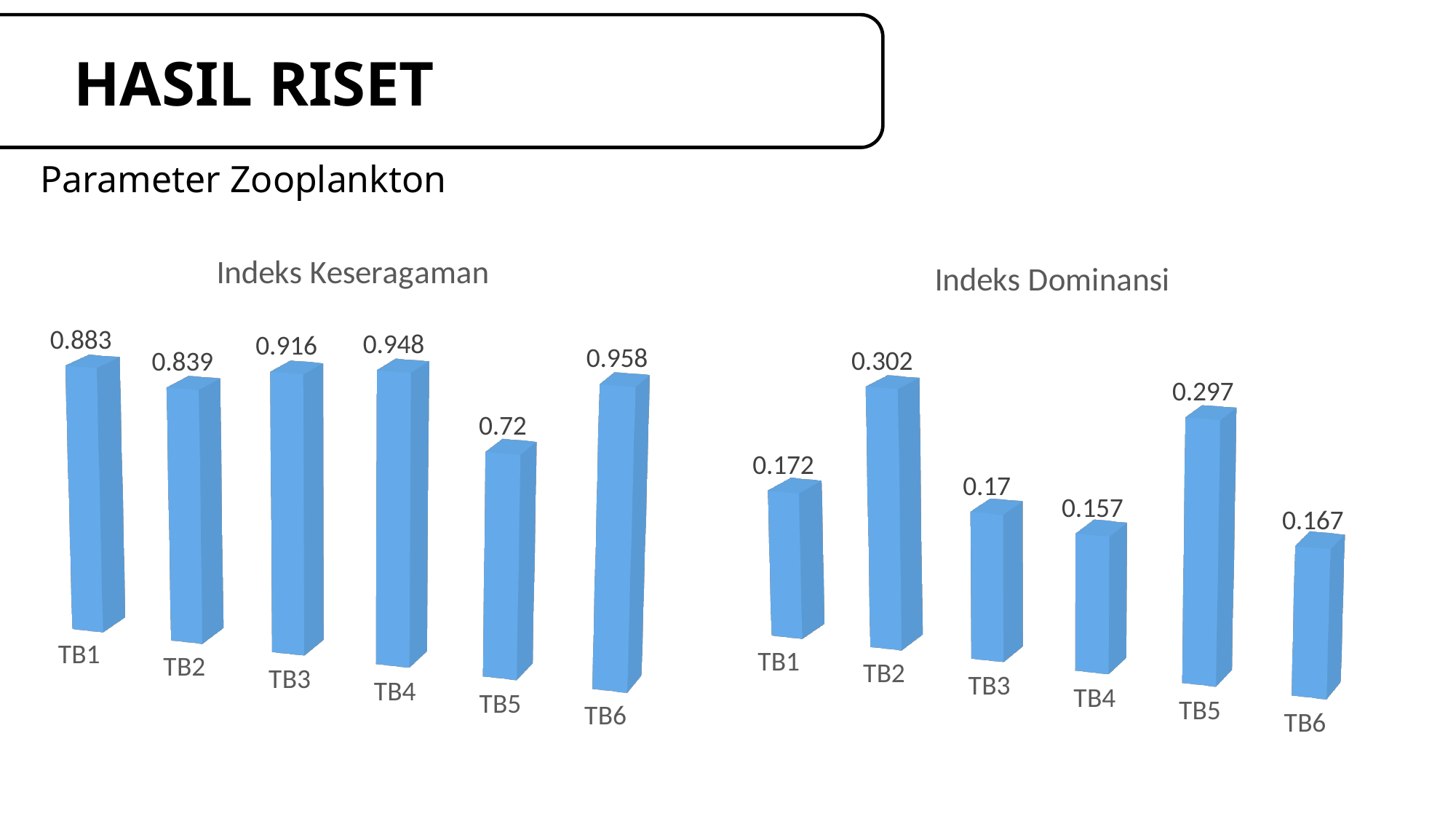
What is the title of the chart on the right side of the slide? Indeks Dominansi In the Indeks Keseragaman chart, what is the value for TB4? 0.948 In the Indeks Keseragaman chart, which category has the lowest value? TB5 In the Indeks Dominansi chart, which category has the lowest value? TB4 In the Indeks Dominansi chart, what is the value for TB5? 0.297 In the Indeks Keseragaman chart, what is the difference between the values for TB6 and TB5? 0.238 What kind of chart is the Indeks Keseragaman chart? bar chart In the Indeks Keseragaman chart, which category has the highest value? TB6 In the Indeks Dominansi chart, what is the difference between the values for TB2 and TB1? 0.13 In the Indeks Keseragaman chart, which is larger, the value for TB1 or the value for TB2? TB1 In the Indeks Dominansi chart, which category has the highest value? TB2 How many categories are shown in the Indeks Dominansi chart? 6